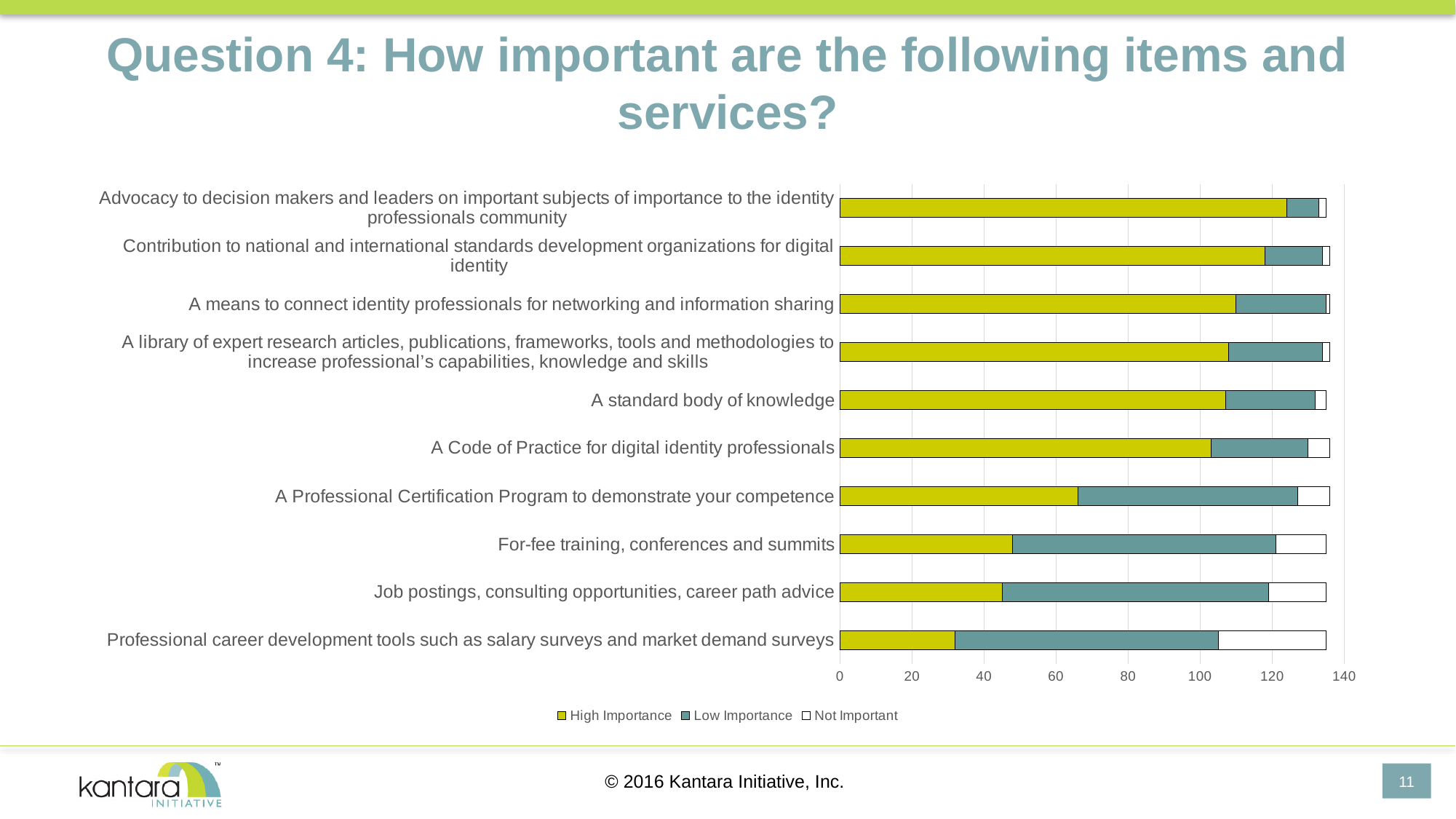
Which colour represents the High Importance series in the chart? Yellow-green Is the High Importance value for 'Professional career development tools such as salary surveys and market demand surveys' greater or less than 40? less Moving down the list of categories from top to bottom, does the High Importance segment generally increase or decrease? decrease Is the High Importance value for 'A Professional Certification Program to demonstrate your competence' greater or less than 60? greater Which category has the longest High Importance segment? Advocacy to decision makers and leaders on important subjects of importance to the identity professionals community Which has the larger High Importance value: 'For-fee training, conferences and summits' or 'A standard body of knowledge'? A standard body of knowledge What kind of chart is shown on the slide? Stacked bar chart Which category has the shortest High Importance segment? Professional career development tools such as salary surveys and market demand surveys How many items and services are listed as categories in the chart? 10 How many series does the legend list? 3 Which category has the largest Not Important segment? Professional career development tools such as salary surveys and market demand surveys